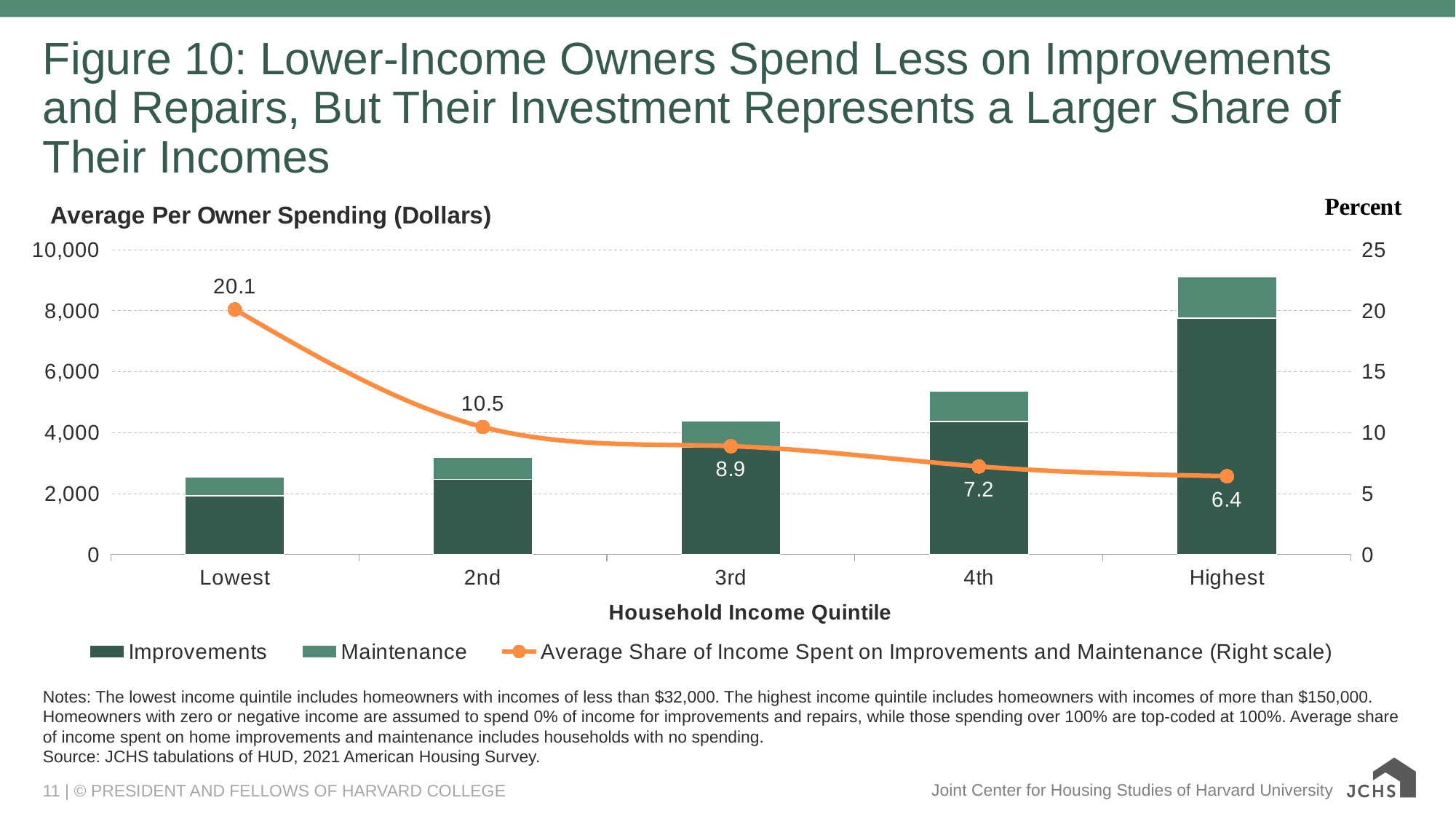
What is the difference in average share of income spent between the Lowest and 2nd income quintiles? 9.6 Which household income quintile has the lowest average share of income spent on improvements and maintenance? Highest What is the average share of income spent on improvements and maintenance for the Highest income quintile? 6.4 What is the average share of income spent on improvements and maintenance for the Lowest income quintile? 20.1 How many series does the legend list? 3 Is the total average per owner spending for the Lowest income quintile greater or less than 4,000? less Which has a larger average share of income spent on improvements and maintenance, the 2nd or the 3rd quintile? 2nd How many household income quintiles are shown on the x axis? 5 Is the total average per owner spending for the Highest income quintile greater or less than 8,000? greater Which household income quintile has the highest average share of income spent on improvements and maintenance? Lowest What is the average share of income spent on improvements and maintenance for the 3rd income quintile? 8.9 How does the average share of income spent on improvements and maintenance change from the Lowest to the Highest quintile? It falls